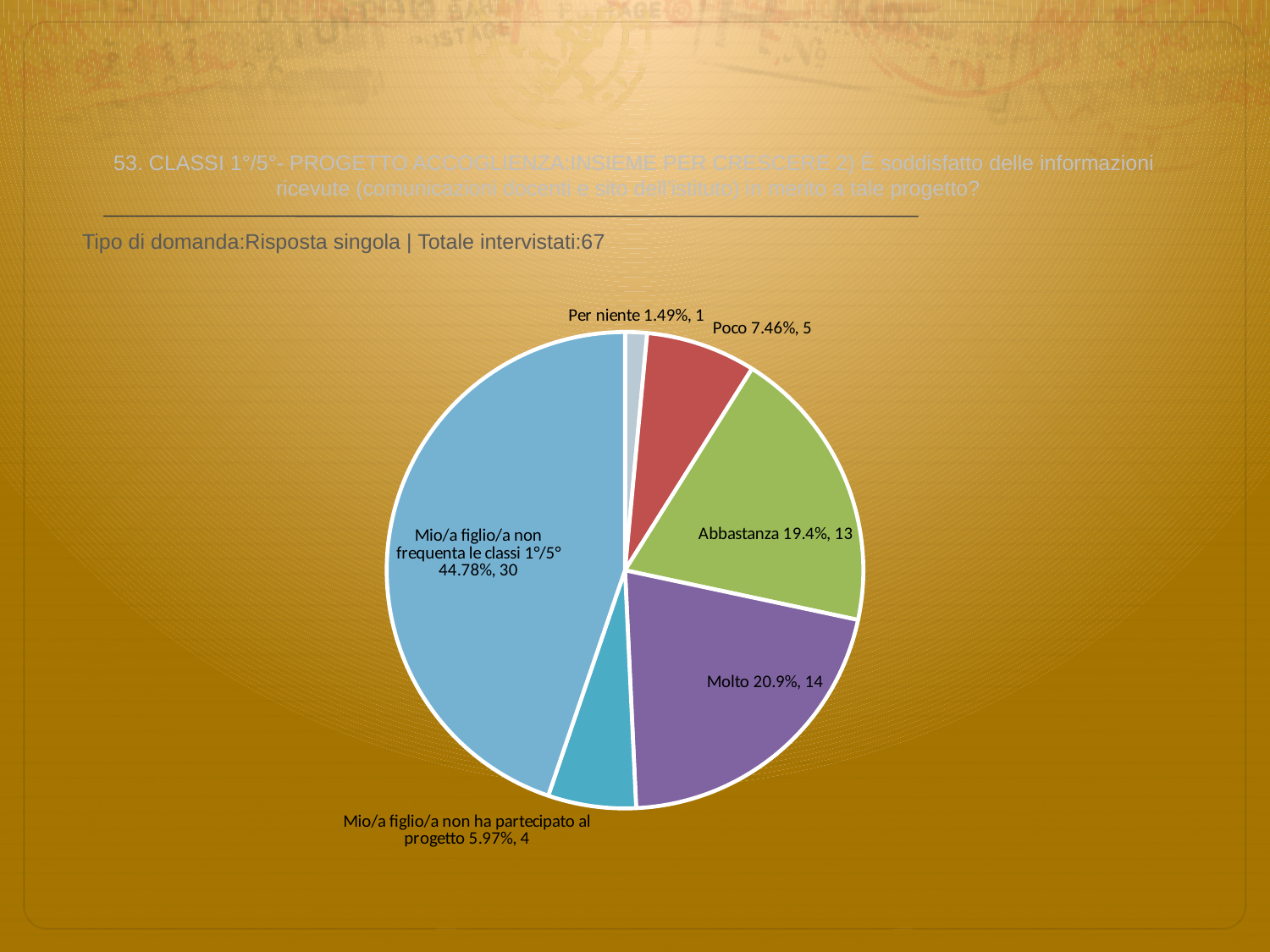
What percentage is shown for 'Poco'? 7.46% Which category has the largest slice of the pie? Mio/a figlio/a non frequenta le classi 1°/5° What is the total number of respondents stated on the slide? 67 Which is larger, the 'Poco' slice or the 'Mio/a figlio/a non ha partecipato al progetto' slice? Poco What share of the pie does 'Mio/a figlio/a non frequenta le classi 1°/5°' represent? 44.78% Which category has the smallest slice of the pie? Per niente How many respondents chose 'Per niente'? 1 What is the difference in respondent count between 'Molto' and 'Abbastanza'? 1 How many slices does the pie chart have? 6 What percentage is shown for the 'Molto' slice? 20.9% What kind of chart is shown on the slide? pie chart How many respondents chose 'Abbastanza'? 13